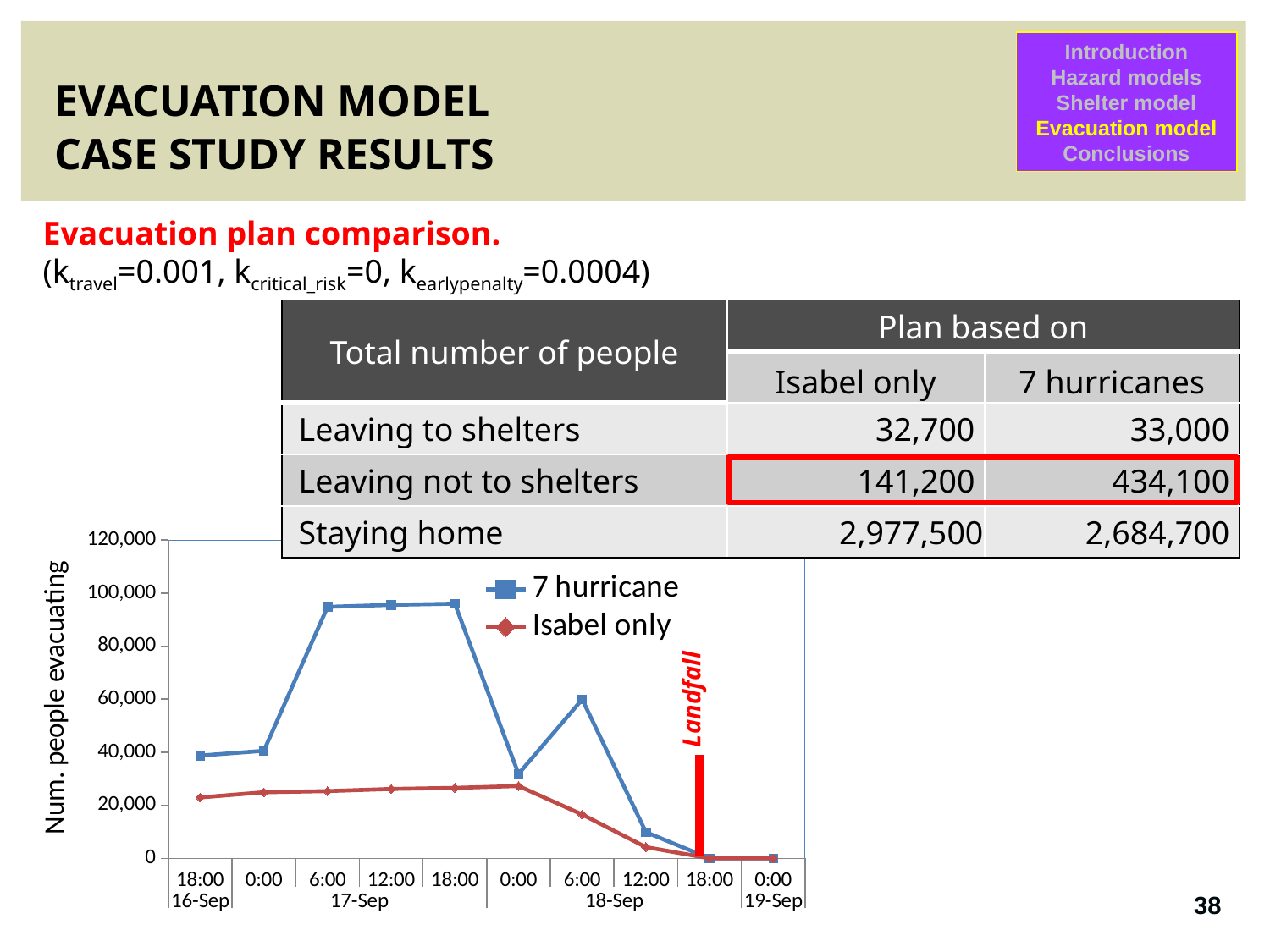
At 6:00 on 18-Sep, which series has the higher value, 7 hurricane or Isabel only? 7 hurricane Is the value for the Isabel only series at 0:00 on 18-Sep greater or less than 40,000? less How many time points are plotted along the x axis of the chart? 10 Is the value for the 7 hurricane series at 6:00 on 18-Sep greater or less than 40,000? greater Is the value for the 7 hurricane series at 18:00 on 16-Sep greater or less than 60,000? less What does the red vertical marker on the chart indicate? Landfall What are the two series named in the chart legend? 7 hurricane and Isabel only What kind of chart is shown on the slide? line chart Does the 7 hurricane series rise or fall between 18:00 on 17-Sep and 0:00 on 18-Sep? fall How many series does the chart legend list? 2 For the 7 hurricane series, which is larger: the value at 18:00 on 16-Sep or the value at 12:00 on 18-Sep? 18:00 on 16-Sep